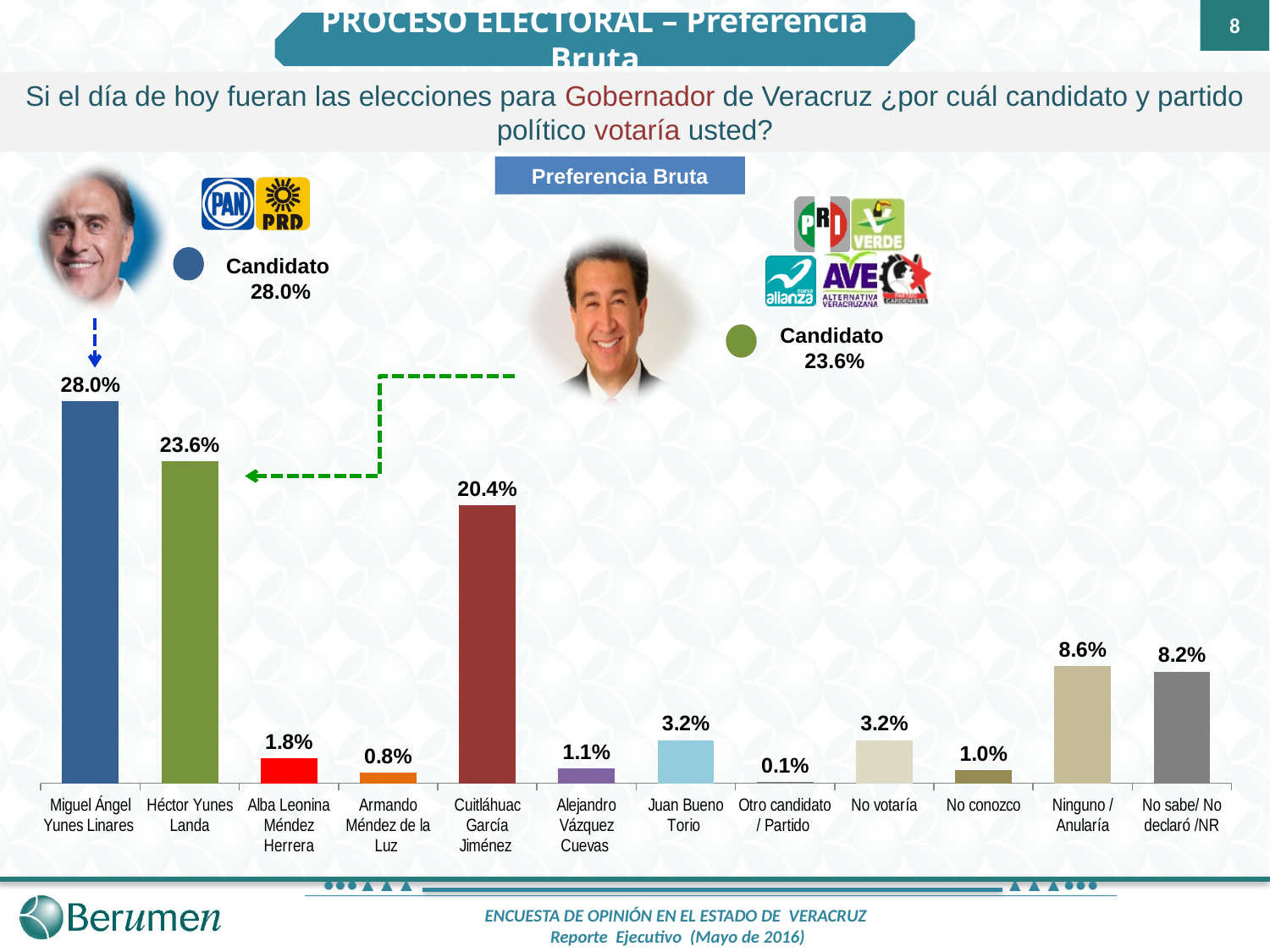
What is the value for Miguel Ángel Yunes Linares? 28.0% What is the title of the chart? Preferencia Bruta Which category has the lowest value? Otro candidato / Partido How many categories are shown on the x axis of the chart? 12 What is the value for Ninguno / Anularía? 8.6% What is the value for Otro candidato / Partido? 0.1% Which category has the highest value? Miguel Ángel Yunes Linares Which is larger, the value for Ninguno / Anularía or the value for No sabe/ No declaró /NR? Ninguno / Anularía What is the value for Cuitláhuac García Jiménez? 20.4% Which is larger, the value for Héctor Yunes Landa or the value for Cuitláhuac García Jiménez? Héctor Yunes Landa What kind of chart is shown on the slide? Bar chart What is the difference between the values for Miguel Ángel Yunes Linares and Héctor Yunes Landa? 4.4%